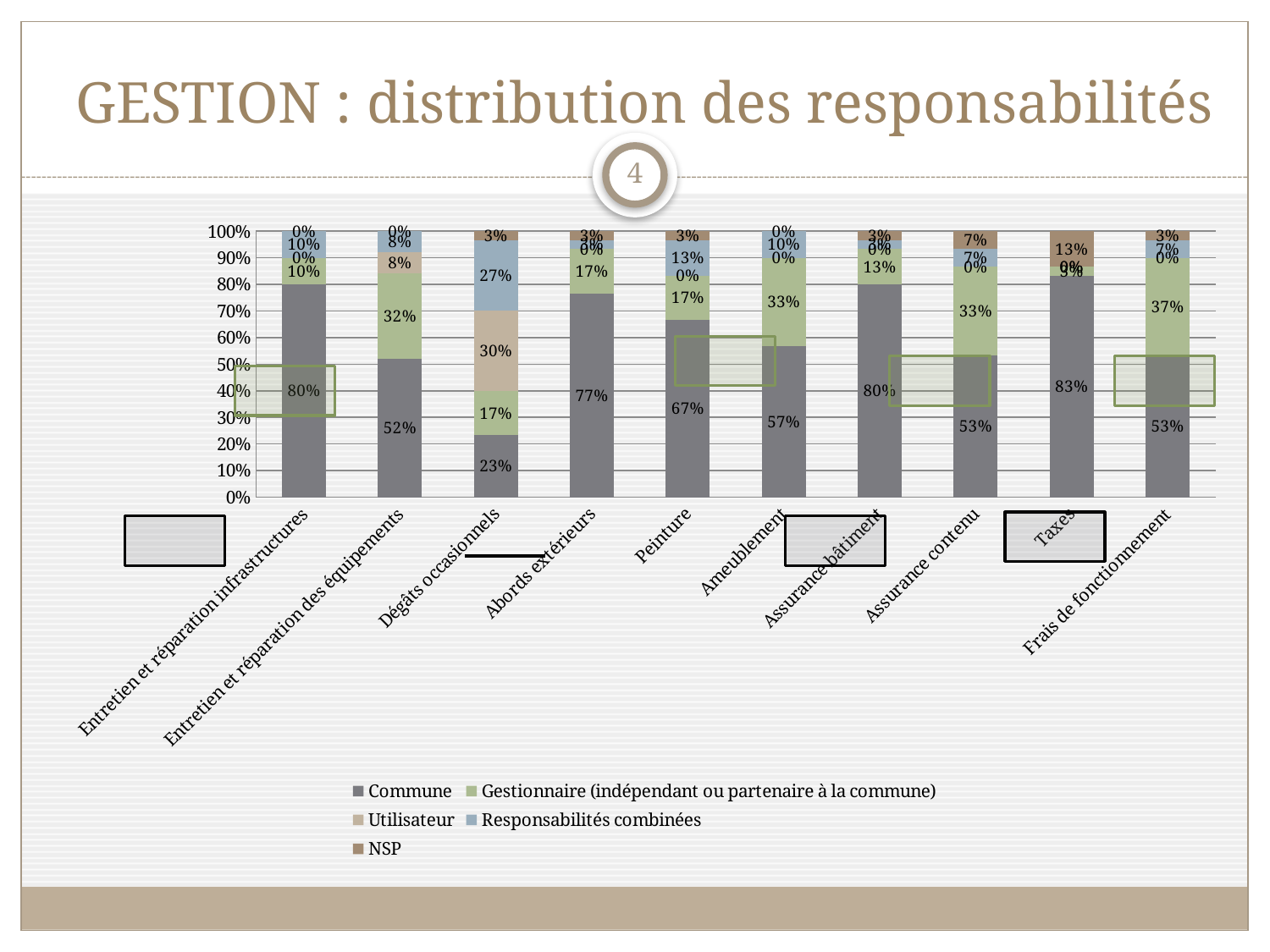
Which category has the highest Commune value? Taxes How many categories are shown on the x axis? 10 What is the Responsabilités combinées value for Dégâts occasionnels? 27% What is the Commune value for Dégâts occasionnels? 23% Which is larger, the Commune value for Entretien et réparation des équipements or for Ameublement? Ameublement What is the difference between the Commune values for Abords extérieurs and Peinture? 10% What is the Utilisateur value for Dégâts occasionnels? 30% How many series does the legend list? 5 What is the Gestionnaire value for Frais de fonctionnement? 37% What type of chart is shown on the slide? stacked bar chart What is the Commune value for Taxes? 83% Which category has the lowest Commune value? Dégâts occasionnels